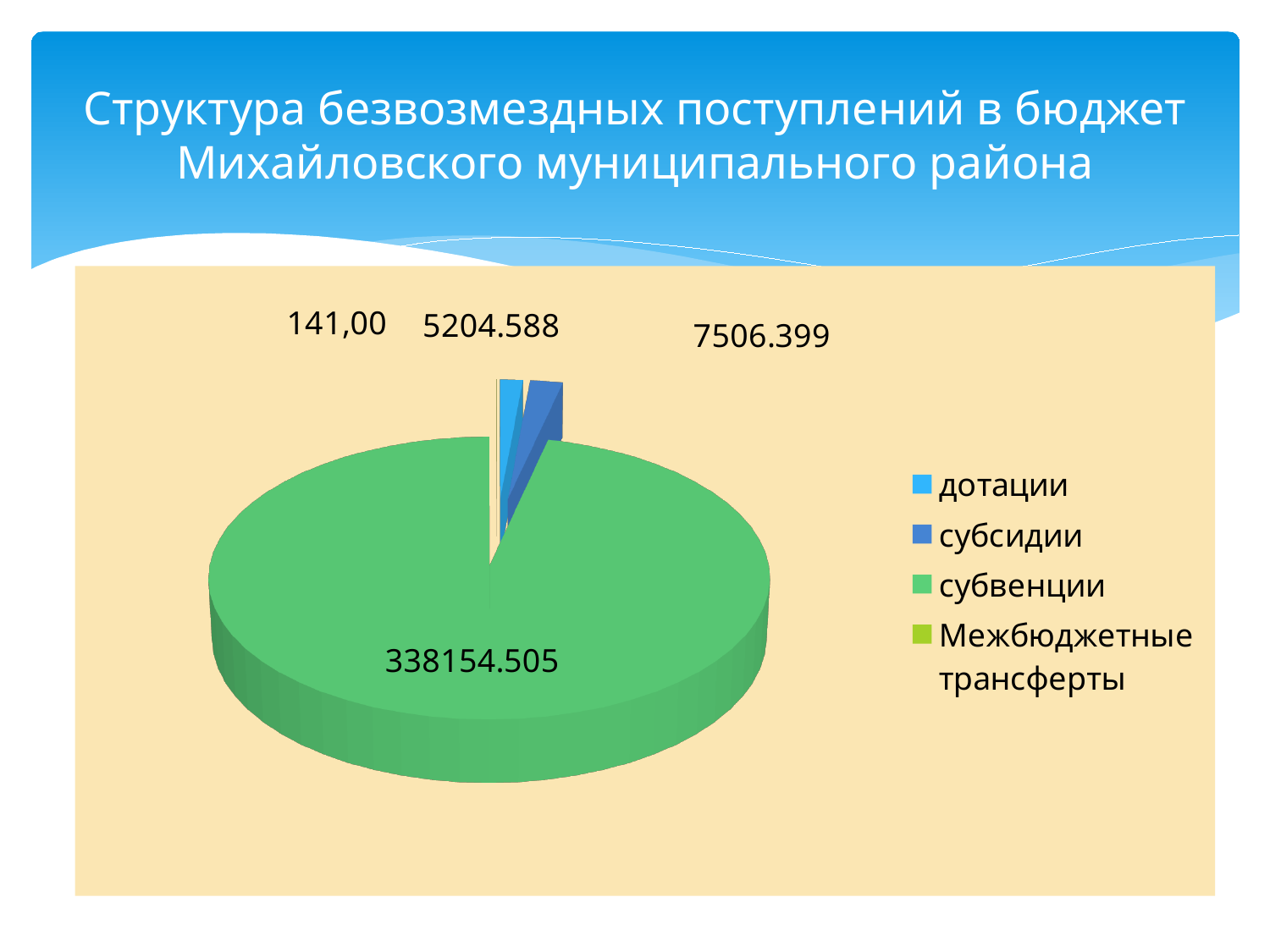
What is the value shown for дотации? 5204.588 Is the value for субвенции greater or less than 300000? greater What is the difference between the values for субсидии and дотации? 2301.811 What is the value shown for субсидии? 7506.399 What is the title of the slide containing the chart? Структура безвозмездных поступлений в бюджет Михайловского муниципального района What kind of chart is shown on the slide? pie chart What colour is the slice for субвенции? green How many categories does the legend list? 4 Which category has the largest slice of the pie? субвенции Which is larger, субсидии or дотации? субсидии What is the value shown for субвенции? 338154.505